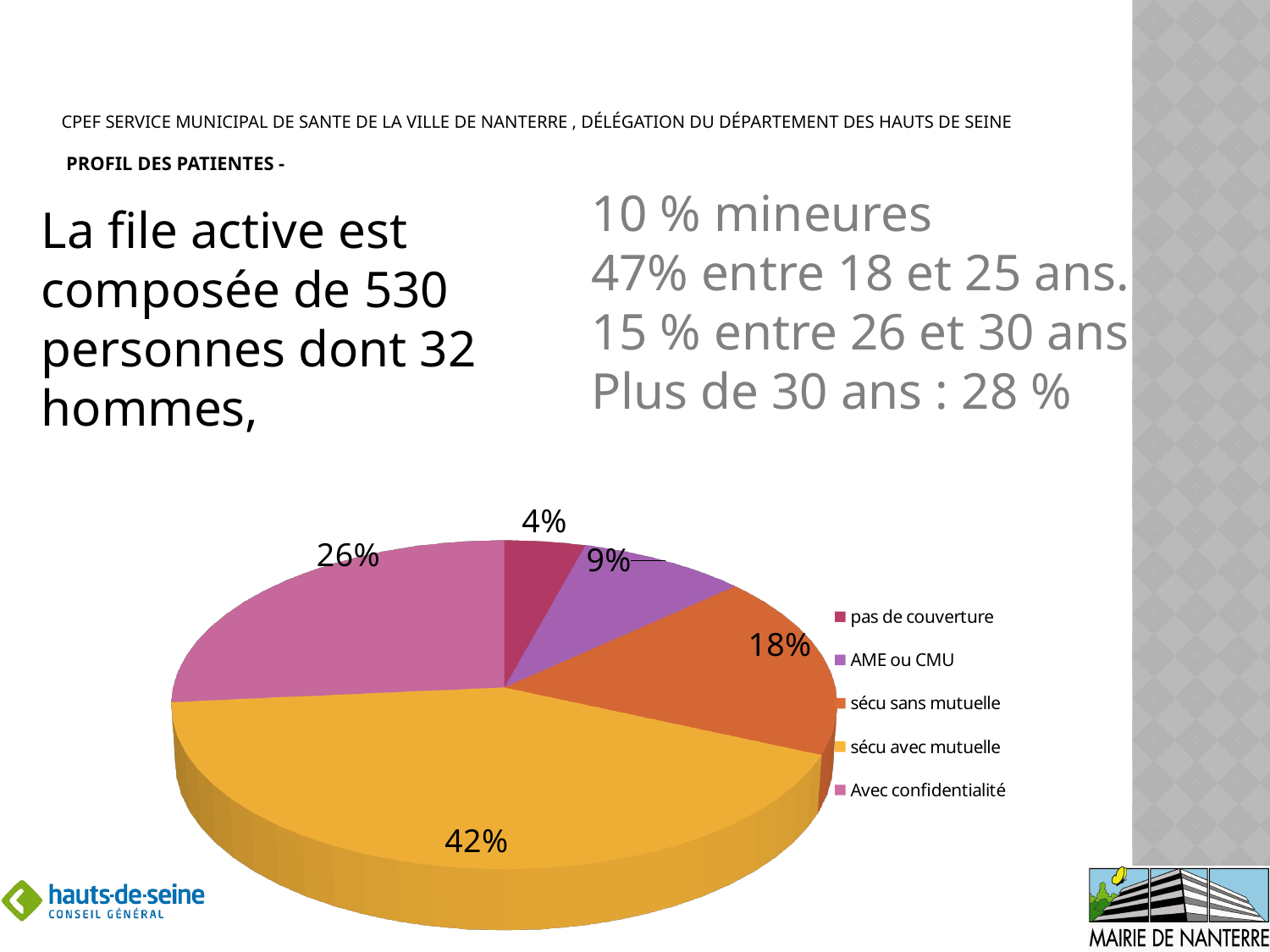
How many categories does the legend of the pie chart list? 5 What percentage is shown for "pas de couverture"? 4% What percentage is shown for "sécu sans mutuelle"? 18% Which category has the largest slice of the pie? sécu avec mutuelle What percentage is shown for "Avec confidentialité"? 26% Which category has the smallest slice of the pie? pas de couverture What colour is the slice for "sécu avec mutuelle"? yellow-orange Which is larger, the slice for "sécu sans mutuelle" or the slice for "AME ou CMU"? sécu sans mutuelle What share of the pie does "sécu avec mutuelle" represent? 42% What is the difference in percentage points between "sécu avec mutuelle" and "Avec confidentialité"? 16 What percentage is shown for "AME ou CMU"? 9% What kind of chart is shown on the slide? pie chart